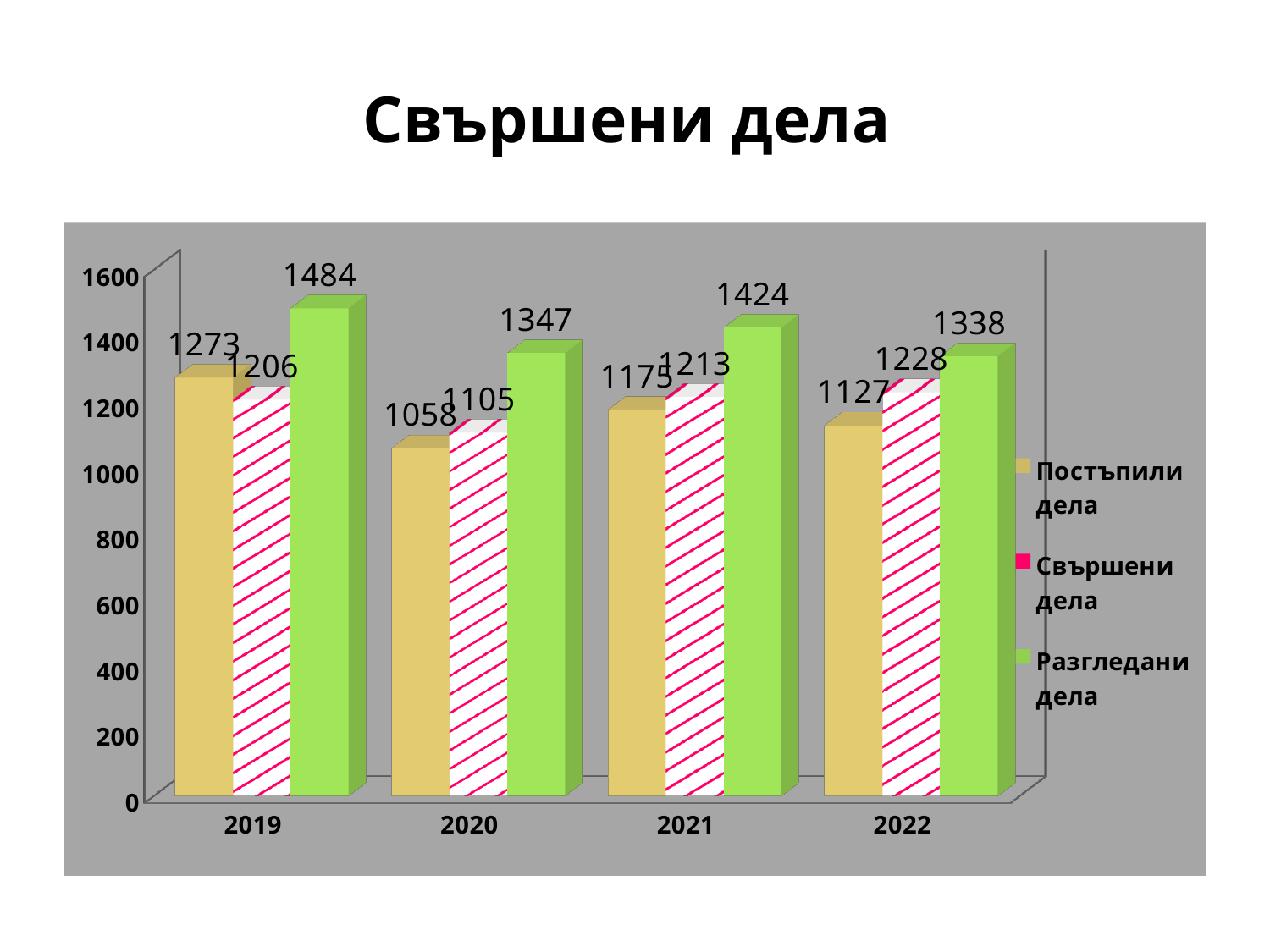
What is the value of Свършени дела for 2022? 1228 Which is larger in 2021: Свършени дела or Постъпили дела? Свършени дела How many series does the legend list? 3 In which year is Постъпили дела lowest? 2020 In which year is Разгледани дела highest? 2019 What kind of chart is shown on the slide? bar chart How many years are shown on the x axis? 4 What is the value of Разгледани дела for 2021? 1424 What is the difference between Разгледани дела and Постъпили дела in 2020? 289 What is the value of Постъпили дела for 2019? 1273 Is the value of Свършени дела for 2020 greater or less than 1200? less What is the title of the chart? Свършени дела